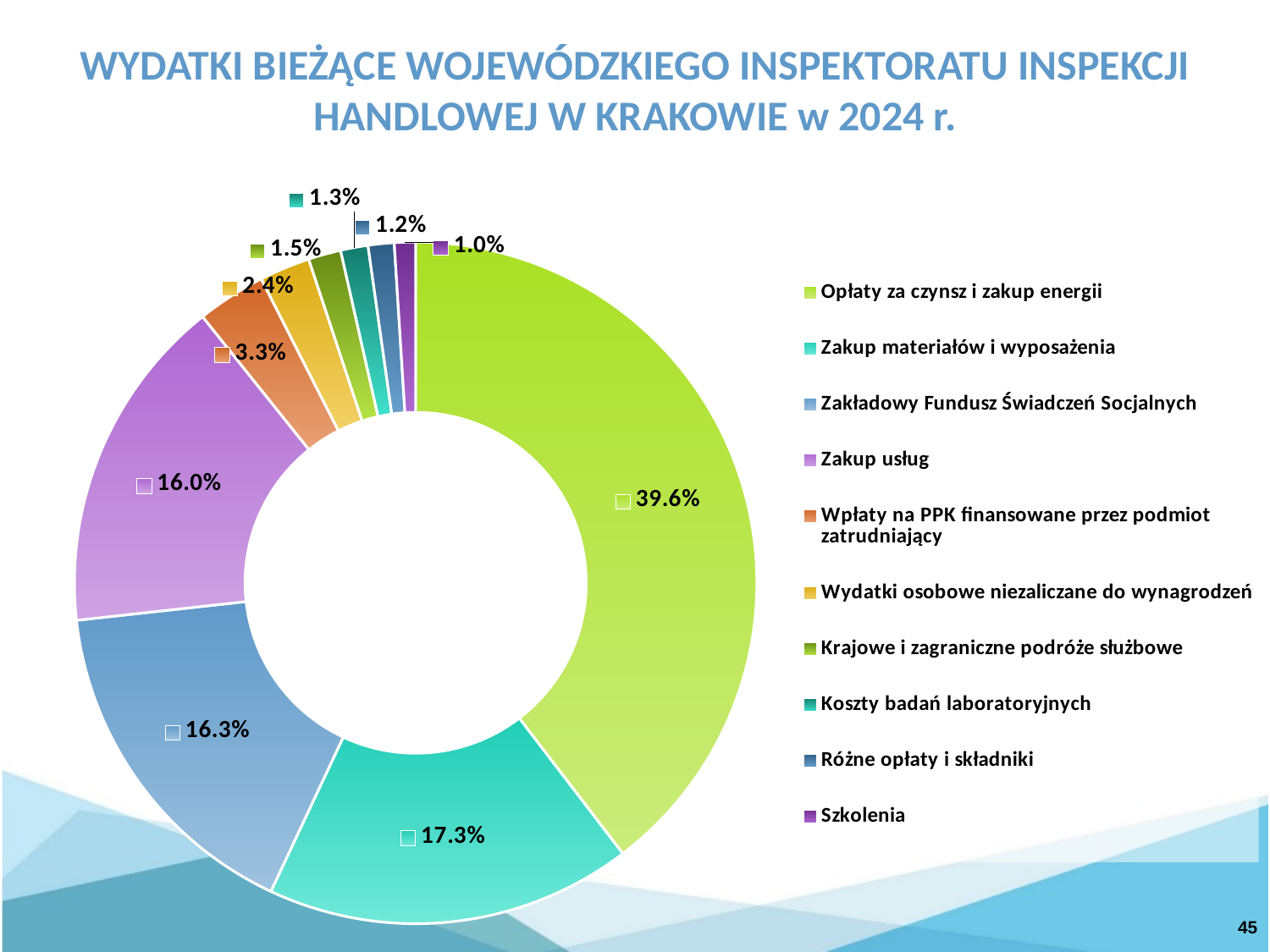
What kind of chart is shown on the slide? doughnut chart Which category has the smallest share of the chart? Szkolenia What is the title of the chart? WYDATKI BIEŻĄCE WOJEWÓDZKIEGO INSPEKTORATU INSPEKCJI HANDLOWEJ W KRAKOWIE w 2024 r. What is the value shown for "Zakup usług"? 16.0% What share of the chart does "Opłaty za czynsz i zakup energii" represent? 39.6% What is the value shown for "Szkolenia"? 1.0% How many categories does the chart show? 10 What is the value shown for "Zakup materiałów i wyposażenia"? 17.3% Which category has the largest share of the chart? Opłaty za czynsz i zakup energii Which is larger: the share for "Wpłaty na PPK finansowane przez podmiot zatrudniający" or for "Wydatki osobowe niezaliczane do wynagrodzeń"? Wpłaty na PPK finansowane przez podmiot zatrudniający What is the difference between the shares of "Zakup materiałów i wyposażenia" and "Zakup usług"? 1.3% What is the value shown for "Zakładowy Fundusz Świadczeń Socjalnych"? 16.3%